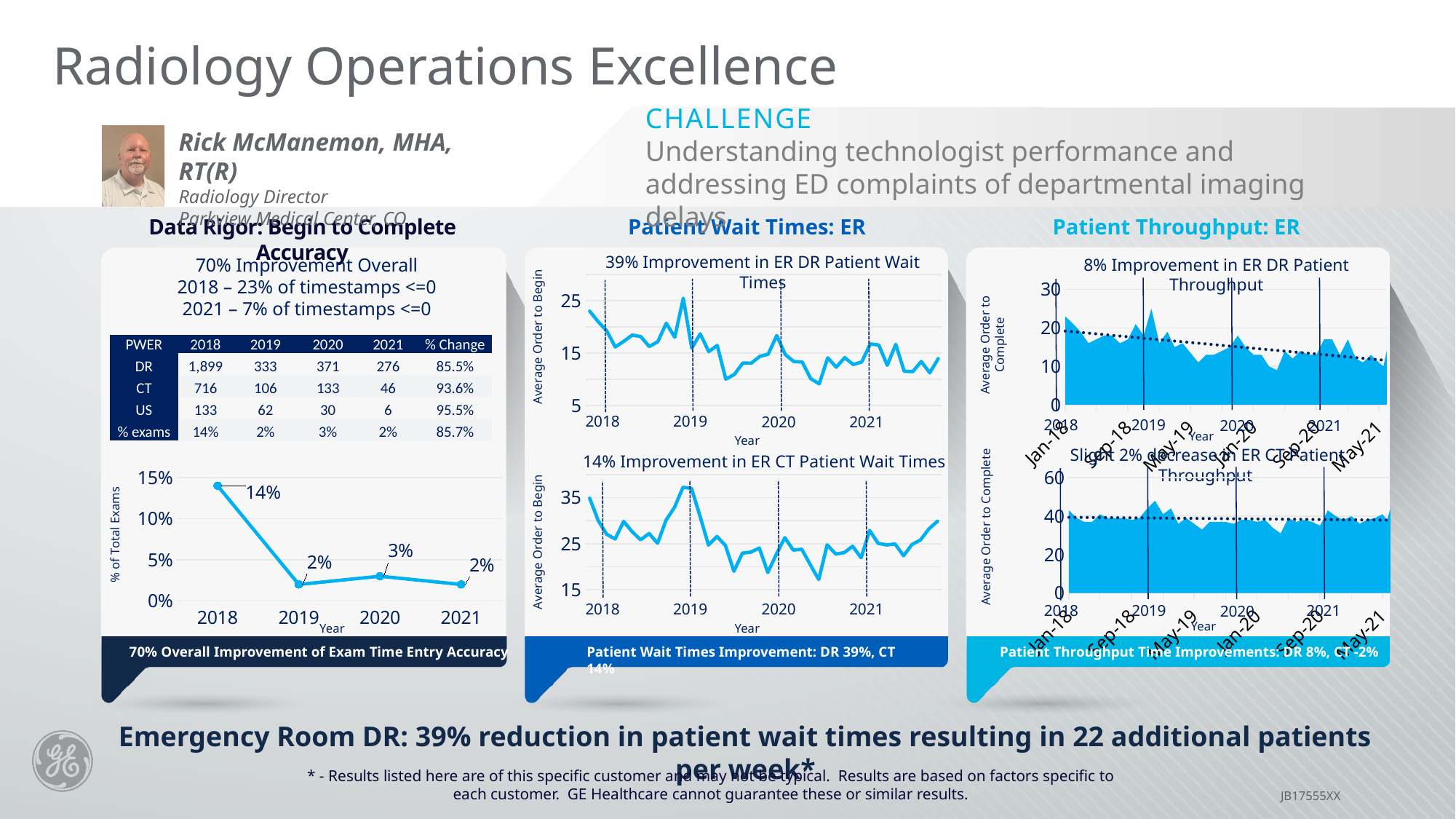
On the '39% Improvement in ER DR Patient Wait Times' chart, do the values generally rise or fall from 2018 to 2021? Fall On the '14% Improvement in ER CT Patient Wait Times' chart, is the last value in 2021 greater or less than 25? greater On the '39% Improvement in ER DR Patient Wait Times' chart, is the value at the start of 2018 greater or less than 15? greater On the '% of Total Exams' line chart in the Data Rigor panel, what is the difference between the 2018 and 2019 values? 12 percentage points On the '% of Total Exams' line chart in the Data Rigor panel, which year has the highest value? 2018 What is the y-axis label on the '39% Improvement in ER DR Patient Wait Times' chart? Average Order to Begin On the '% of Total Exams' line chart in the Data Rigor panel, what is the value for 2020? 3% On the '% of Total Exams' line chart in the Data Rigor panel, is the 2020 value larger or smaller than the 2018 value? Smaller On the '% of Total Exams' line chart in the Data Rigor panel, what is the value for 2018? 14% On the '% of Total Exams' line chart in the Data Rigor panel, how many data points are plotted? 4 What is the title of the upper chart in the Patient Throughput: ER panel? 8% Improvement in ER DR Patient Throughput What kind of chart is the '% of Total Exams' chart in the Data Rigor panel? Line chart